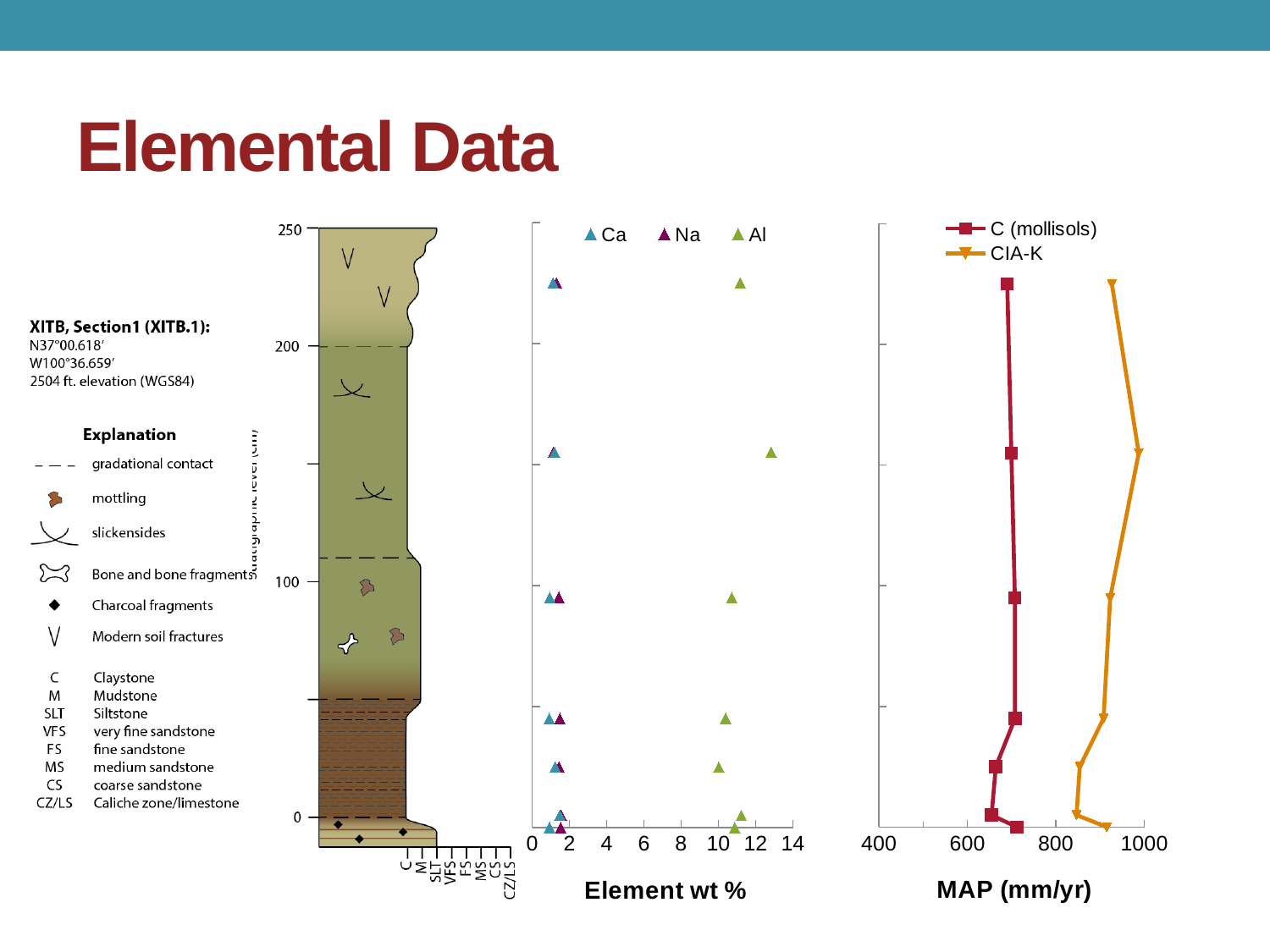
How many series does the legend of the Element wt % chart list? 3 How many data points does the C (mollisols) series have in the MAP (mm/yr) chart? 7 In the MAP (mm/yr) chart, is the CIA-K value at the stratigraphic level of about 150 cm greater or less than 900? greater Which series are listed in the legend of the Element wt % chart? Ca, Na, Al In the Element wt % chart, which series has the highest values, Ca, Na or Al? Al In the MAP (mm/yr) chart, are the C (mollisols) values greater or less than 800? less What kind of chart is the MAP (mm/yr) chart? line chart In the Element wt % chart, is the Al value at the stratigraphic level of about 150 cm greater or less than 12? greater How many series does the legend of the MAP (mm/yr) chart list? 2 In the MAP (mm/yr) chart, which series has larger values, C (mollisols) or CIA-K? CIA-K What is the x-axis title of the right-hand chart? MAP (mm/yr)